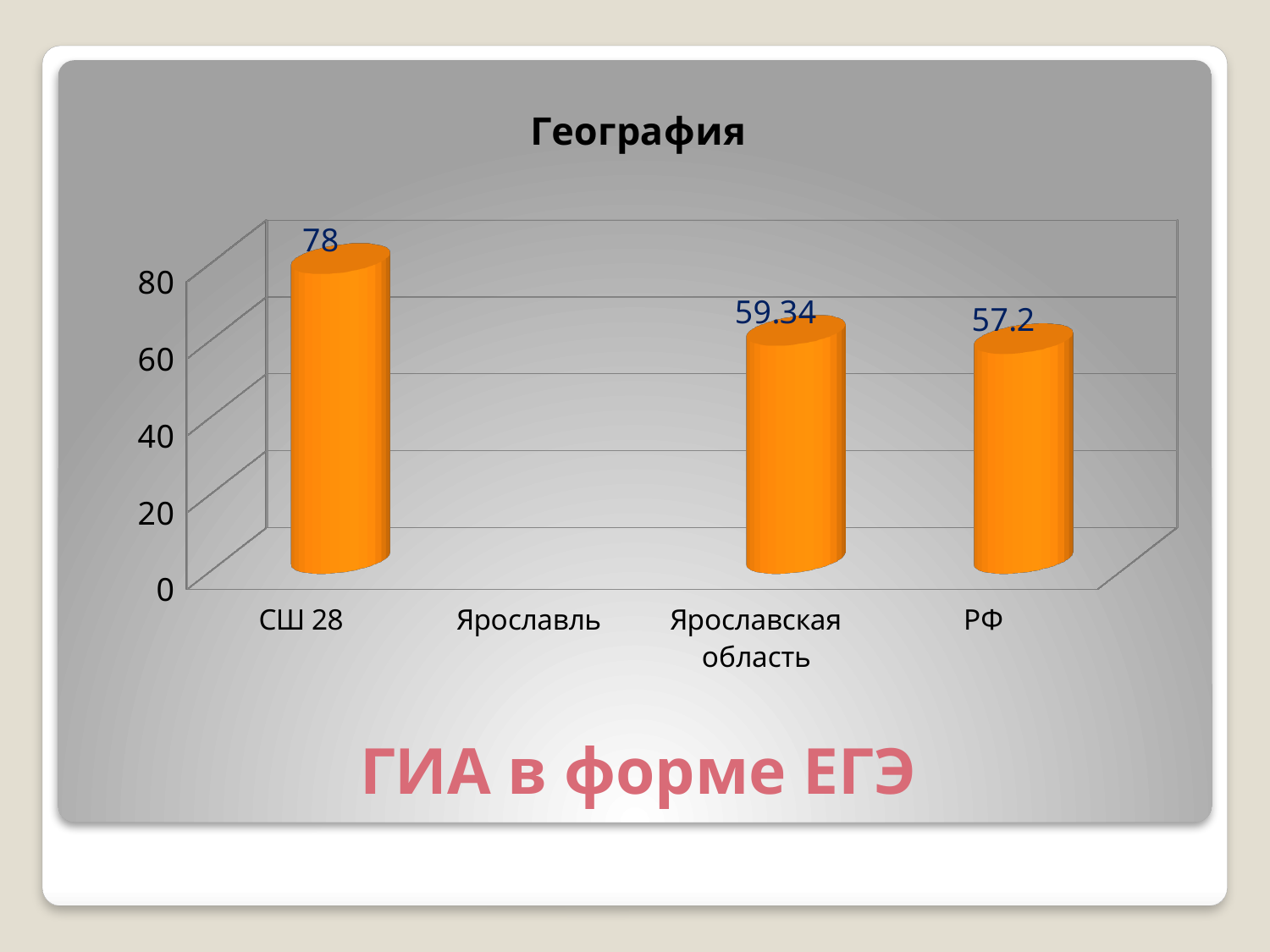
How many categories are shown on the x axis? 4 Is the value for РФ greater or less than 60? less Which category on the x axis has no bar shown? Ярославль Which category has the highest value? СШ 28 What is the value for СШ 28? 78 What is the value for Ярославская область? 59.34 What is the difference between the values for СШ 28 and РФ? 20.8 Which is larger, the value for СШ 28 or the value for Ярославская область? СШ 28 What kind of chart is this? bar chart What is the value for РФ? 57.2 What is the difference between the values for Ярославская область and РФ? 2.14 What is the title of the chart? География